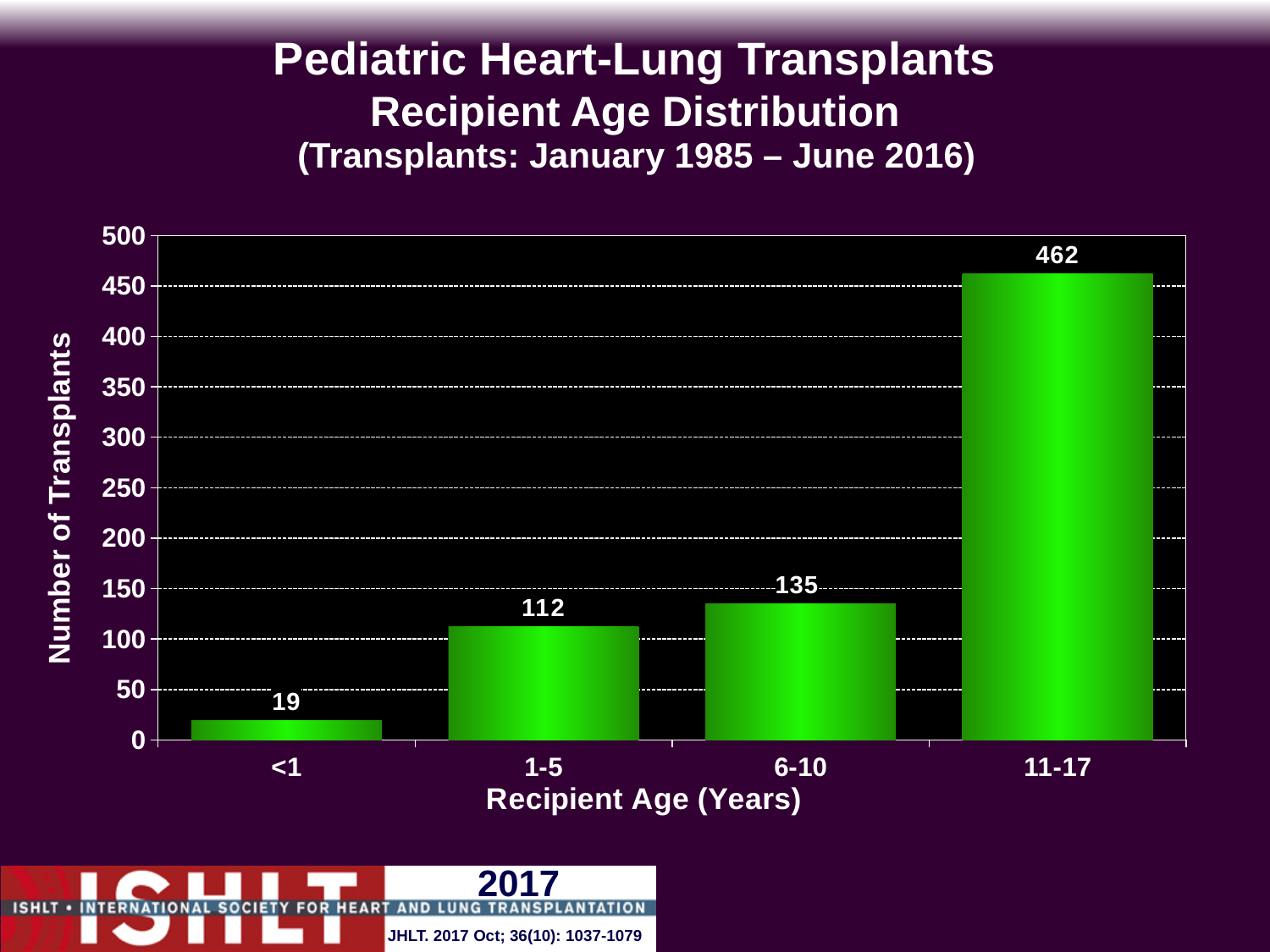
What is the number of transplants for recipients aged <1 year? 19 What kind of chart is shown on the slide? bar chart Do the number of transplants rise or fall as recipient age increases along the x axis? rise Is the value for the 11-17 age group greater or less than 450? greater What is the number of transplants for the 1-5 age group? 112 How many recipient age groups are shown on the chart? 4 Which recipient age group has the lowest number of transplants? <1 Which recipient age group has the highest number of transplants? 11-17 How many transplants were performed for recipients aged 11-17? 462 What is the label of the y axis? Number of Transplants Which age group has more transplants, 6-10 or 1-5? 6-10 What is the difference in number of transplants between the 6-10 and 1-5 age groups? 23